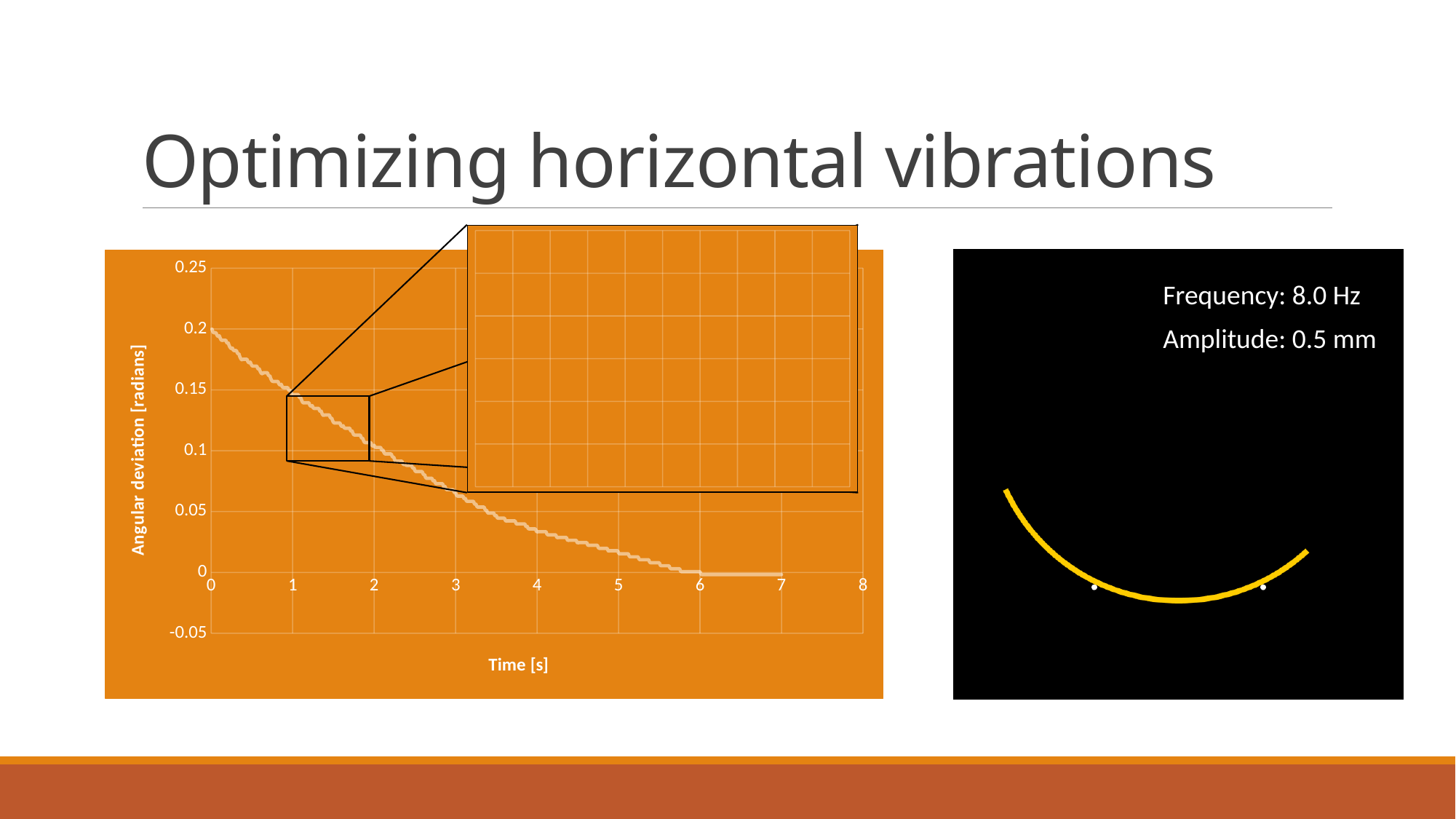
What is the angular deviation at time 0 s? 0.2 Does the angular deviation rise or fall as time increases from 0 to 6 seconds? fall Which is larger, the angular deviation at time 1 s or at time 5 s? time 1 s What value does the angular deviation settle at after about 6 s? 0 What is the label of the y axis of the chart? Angular deviation [radians] Is the angular deviation at time 4 s greater or less than 0.1? less What is the highest value shown on the y axis of the chart? 0.25 What is the label of the x axis of the chart? Time [s] Is the angular deviation at time 5 s greater or less than 0.05? less What kind of chart is shown on the left of the slide? line chart